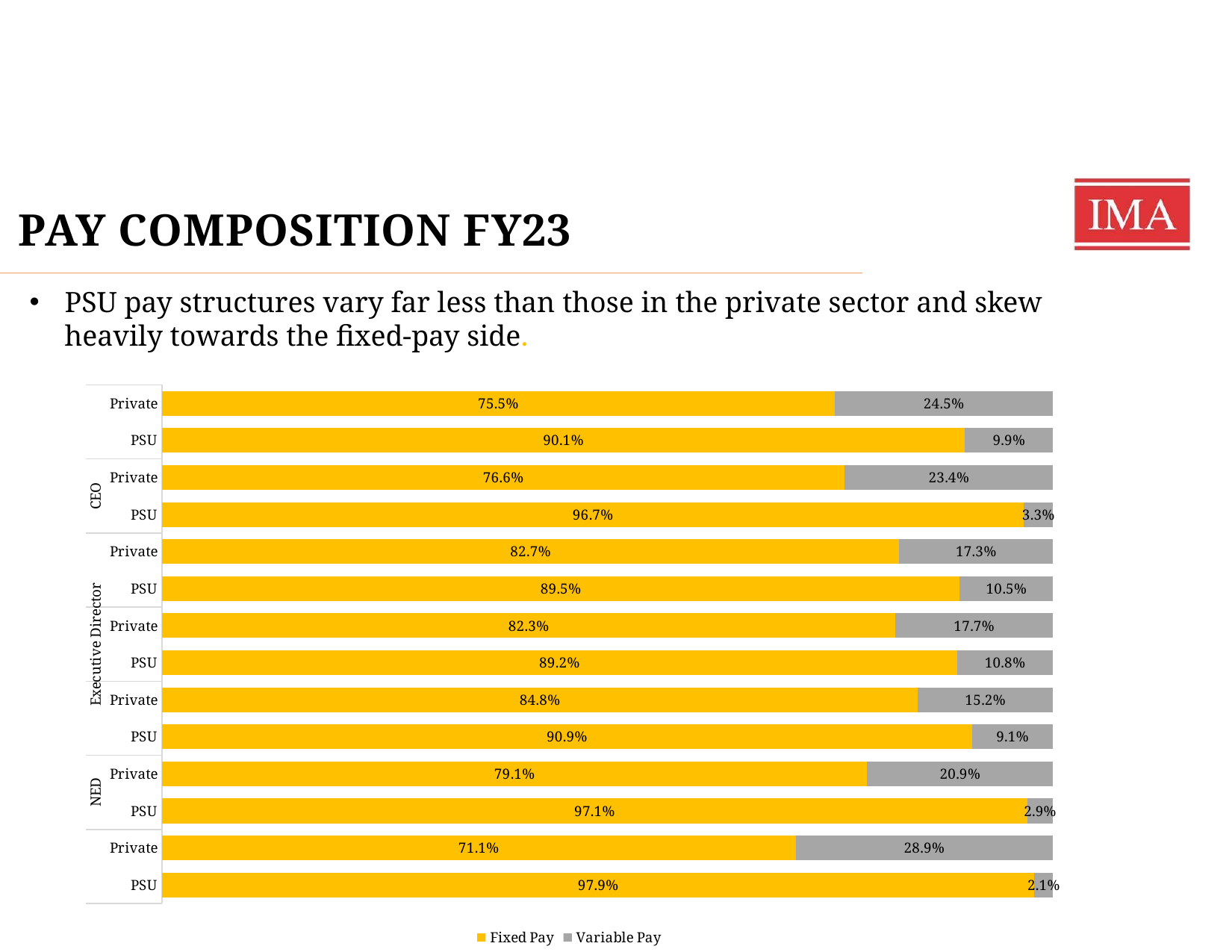
Which bar has the lowest Variable Pay share? The bottom PSU bar (2.1%) What is the Variable Pay share for the NED Private bar? 20.9% What is the Fixed Pay share for the CEO PSU bar? 96.7% What kind of chart is shown on the slide? Stacked bar chart Which has a larger Fixed Pay share, the CEO Private bar or the NED Private bar? NED Private What is the difference in Fixed Pay share between the CEO PSU bar and the CEO Private bar? 20.1 percentage points What is the Fixed Pay share for the bottom-most bar (PSU)? 97.9% How many series does the legend list? 2 What colour represents Fixed Pay in the chart? Yellow How many bars are plotted in the chart? 14 Which bar has the highest Fixed Pay share? The bottom PSU bar (97.9%) What is the Variable Pay share for the CEO PSU bar? 3.3%